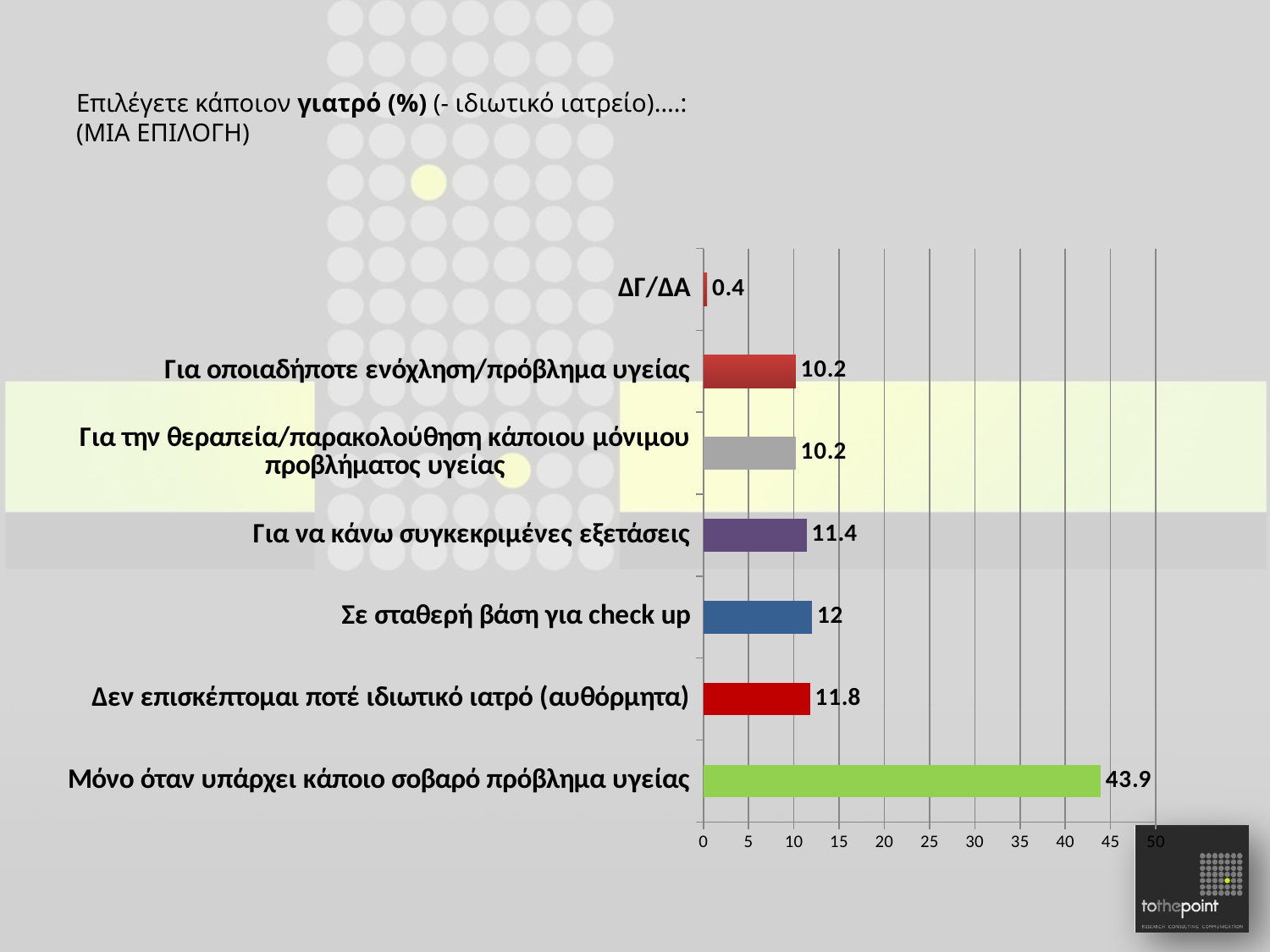
What is the value for 'Δεν επισκέπτομαι ποτέ ιδιωτικό ιατρό (αυθόρμητα)'? 11.8 How many categories are shown in the chart? 7 Which category has the lowest value? ΔΓ/ΔΑ What is the difference between the values for 'Για να κάνω συγκεκριμένες εξετάσεις' and 'Για οποιαδήποτε ενόχληση/πρόβλημα υγείας'? 1.2 Which category has the highest value? Μόνο όταν υπάρχει κάποιο σοβαρό πρόβλημα υγείας What is the value for 'ΔΓ/ΔΑ'? 0.4 What is the maximum value shown on the horizontal axis? 50 What is the value for 'Σε σταθερή βάση για check up'? 12 What kind of chart is shown on the slide? Bar chart What is the value for 'Μόνο όταν υπάρχει κάποιο σοβαρό πρόβλημα υγείας'? 43.9 Which is larger: the value for 'Σε σταθερή βάση για check up' or the value for 'Για οποιαδήποτε ενόχληση/πρόβλημα υγείας'? Σε σταθερή βάση για check up What is the difference between the values for 'Μόνο όταν υπάρχει κάποιο σοβαρό πρόβλημα υγείας' and 'Σε σταθερή βάση για check up'? 31.9